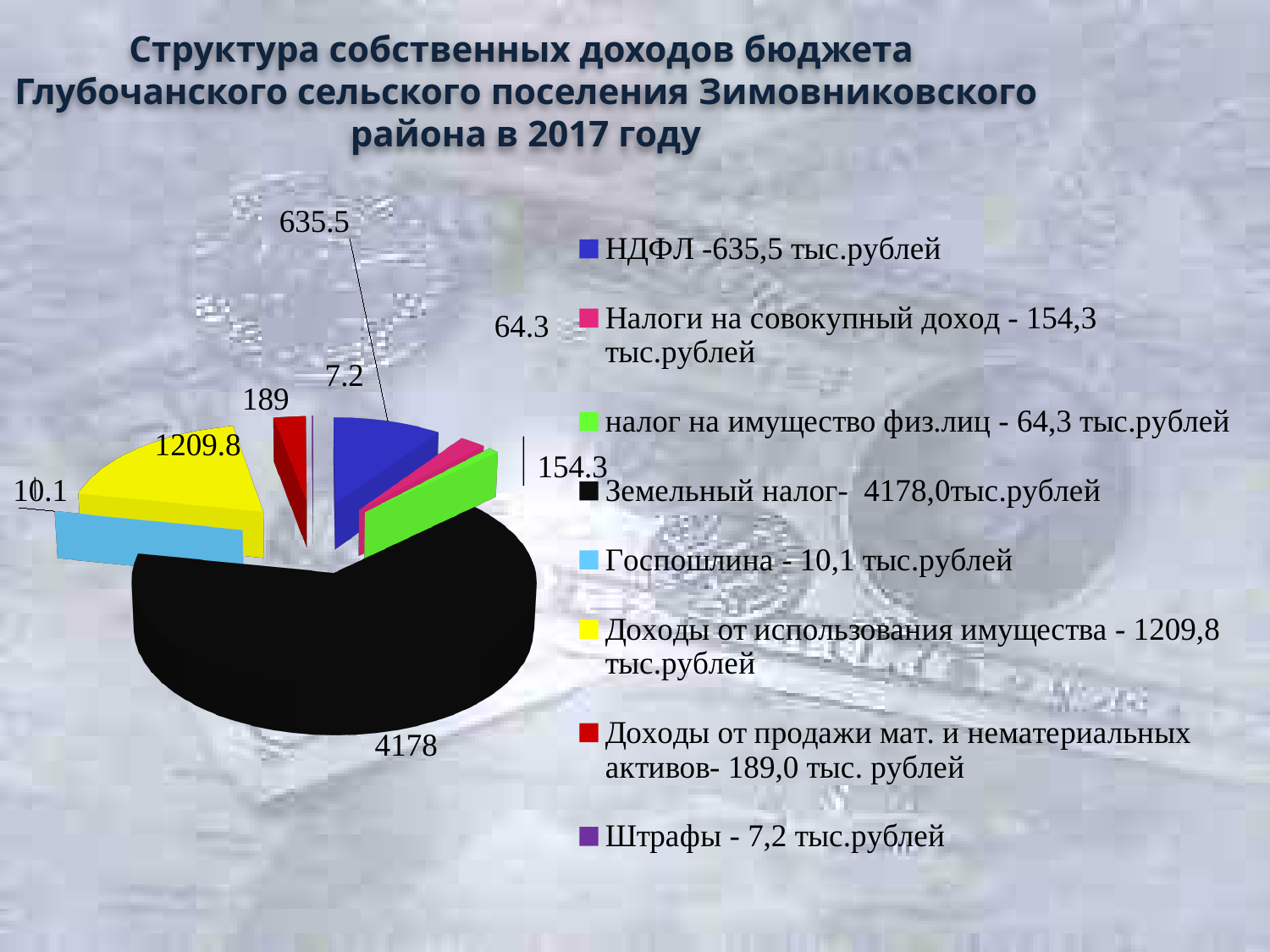
How many entries does the legend list? 8 How many slices does the pie chart have? 8 What is the value of the Госпошлина slice? 10.1 What is the difference between the Доходы от использования имущества value and the НДФЛ value? 574.3 Which is larger: Налоги на совокупный доход or Доходы от продажи мат. и нематериальных активов? Доходы от продажи мат. и нематериальных активов What colour is the Земельный налог slice? black What is the value of the Доходы от использования имущества slice? 1209.8 Which category has the largest slice of the pie? Земельный налог Which category has the smallest slice of the pie? Штрафы What type of chart is shown on the slide? pie chart What is the value of the Земельный налог slice? 4178 What is the value of the НДФЛ slice? 635.5